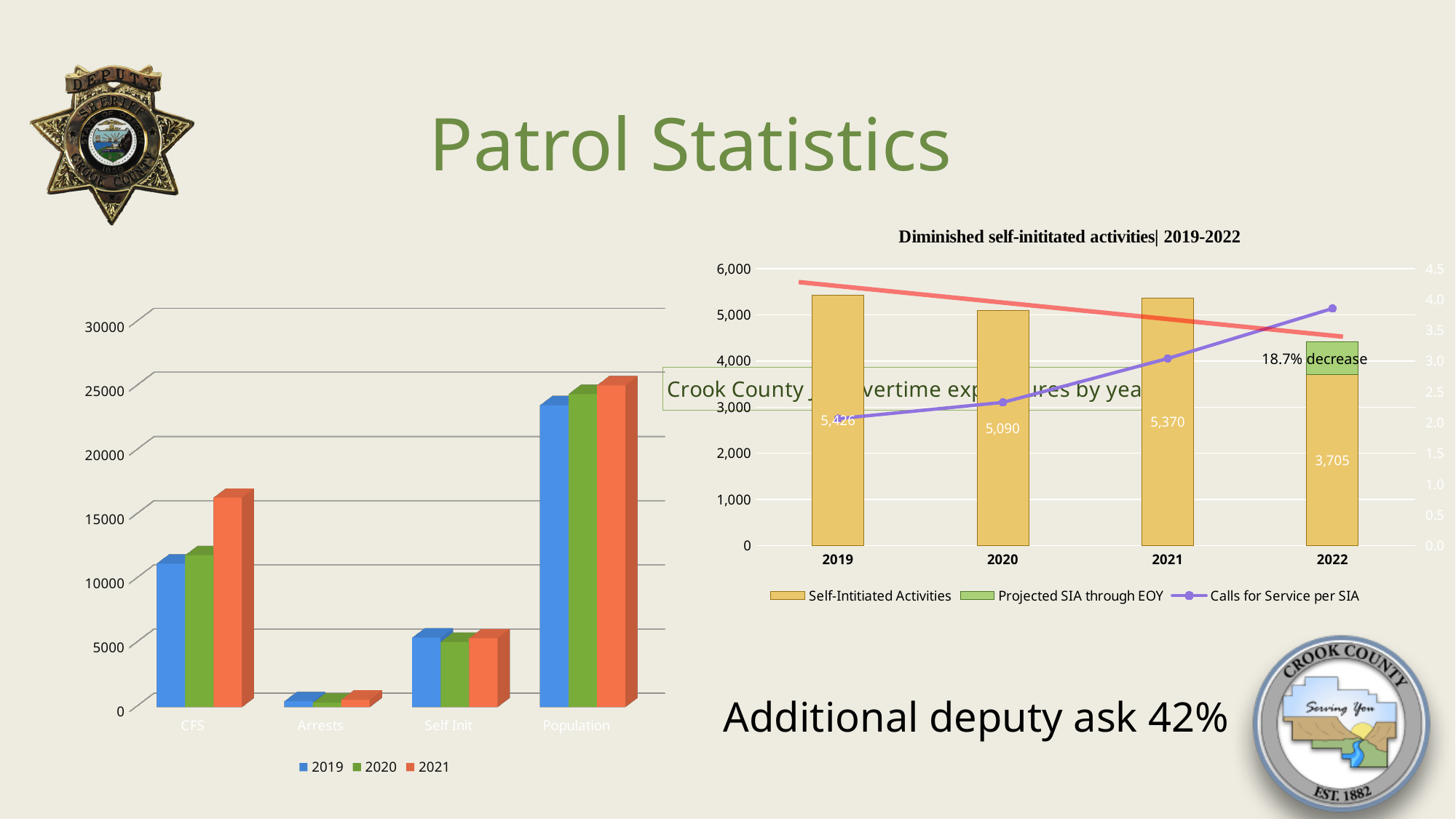
In the chart titled 'Diminished self-inititated activities| 2019-2022', which year has the lowest Self-Intitiated Activities value? 2022 In the chart titled 'Diminished self-inititated activities| 2019-2022', what is the difference between the Self-Intitiated Activities values for 2019 and 2020? 336 In the chart on the left of the slide, is the 2021 value for CFS greater or less than 15000? greater In the chart titled 'Diminished self-inititated activities| 2019-2022', how many series does the legend list? 3 In the chart titled 'Diminished self-inititated activities| 2019-2022', what percentage decrease is annotated on the 2022 bar? 18.7% decrease In the chart on the left of the slide, how many categories are shown on the x axis? 4 What kind of chart is the chart on the left of the slide? bar chart In the chart titled 'Diminished self-inititated activities| 2019-2022', what is the value of Self-Intitiated Activities for 2019? 5,426 In the chart titled 'Diminished self-inititated activities| 2019-2022', does the Calls for Service per SIA line rise or fall from 2019 to 2022? rise In the chart titled 'Diminished self-inititated activities| 2019-2022', which year has the highest Self-Intitiated Activities value? 2019 In the chart titled 'Diminished self-inititated activities| 2019-2022', what is the value of Self-Intitiated Activities for 2022? 3,705 In the chart on the left of the slide, which category has the highest values? Population